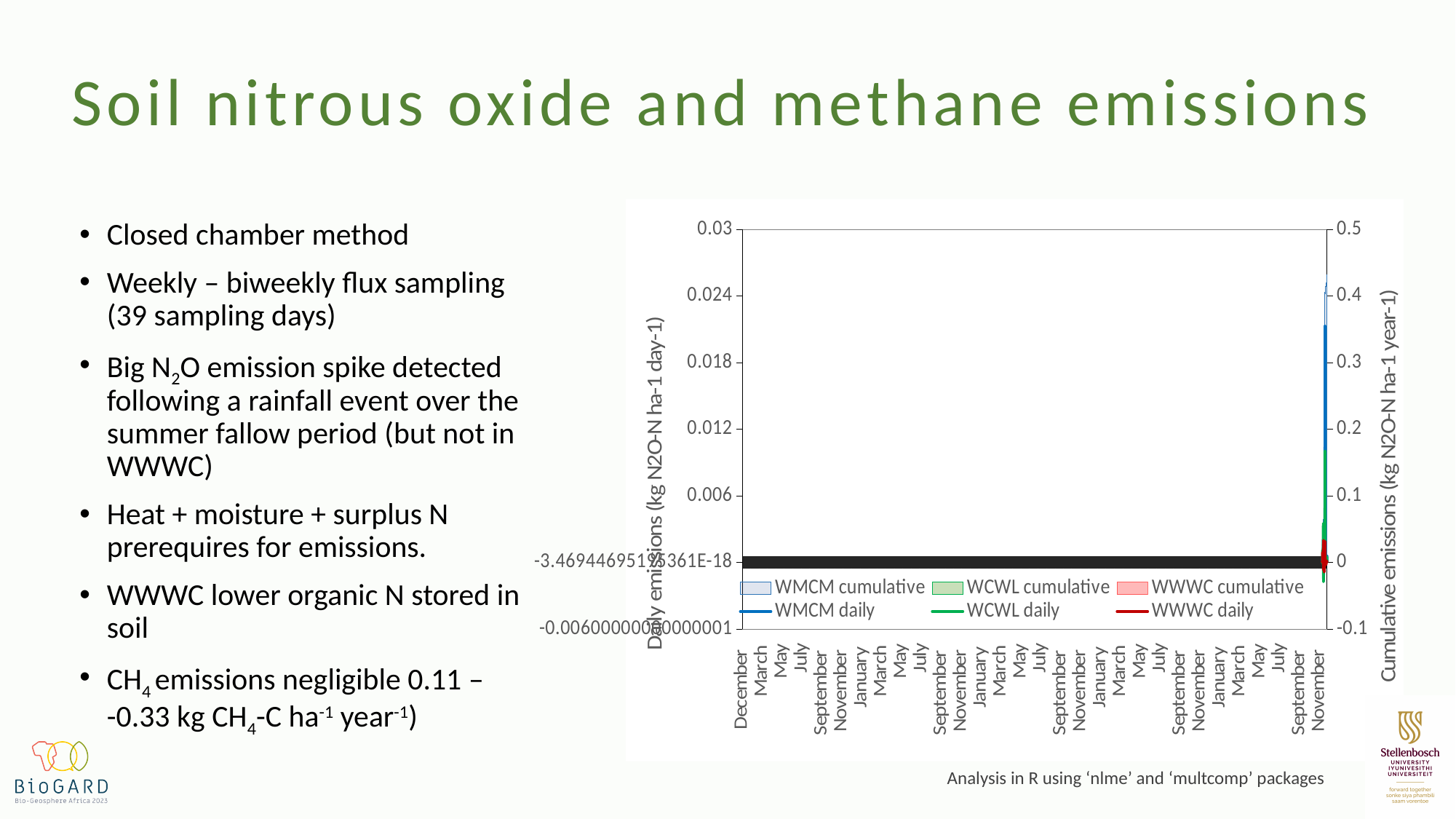
What is the maximum value shown on the left vertical axis of the chart? 0.03 Which month label appears first on the x axis of the chart? December What is the maximum value shown on the right vertical axis of the chart? 0.5 What is the title of the left vertical axis of the chart? Daily emissions (kg N2O-N ha-1 day-1) What kind of chart is shown on the slide? combination area and line chart Which daily series reaches the highest peak in the chart? WMCM daily Which colour is used for the WWWC daily series in the chart? red How many series does the chart legend list? 6